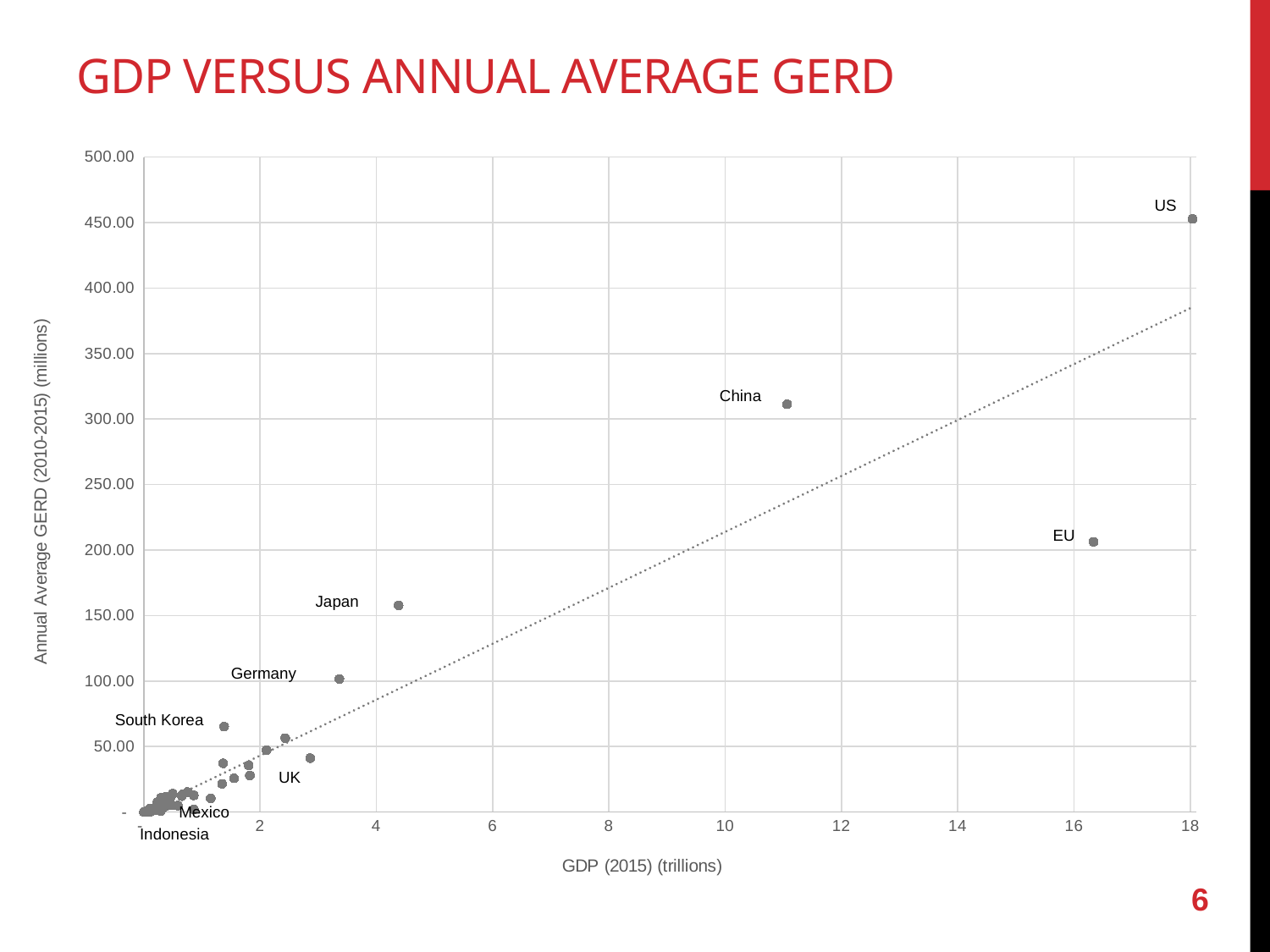
What is the label of the x axis? GDP (2015) (trillions) Does annual average GERD generally rise or fall as GDP increases, according to the dotted trend line? rise Is the GDP (2015) for China greater or less than 10 trillion? greater Which has the larger annual average GERD, Japan or Germany? Japan Is the GDP (2015) for the EU greater or less than 14 trillion? greater Is the annual average GERD for Japan greater or less than 200.00? less Which has the larger annual average GERD, China or the EU? China What kind of chart is shown on the slide? Scatter chart Which labelled country or region has the highest annual average GERD? US